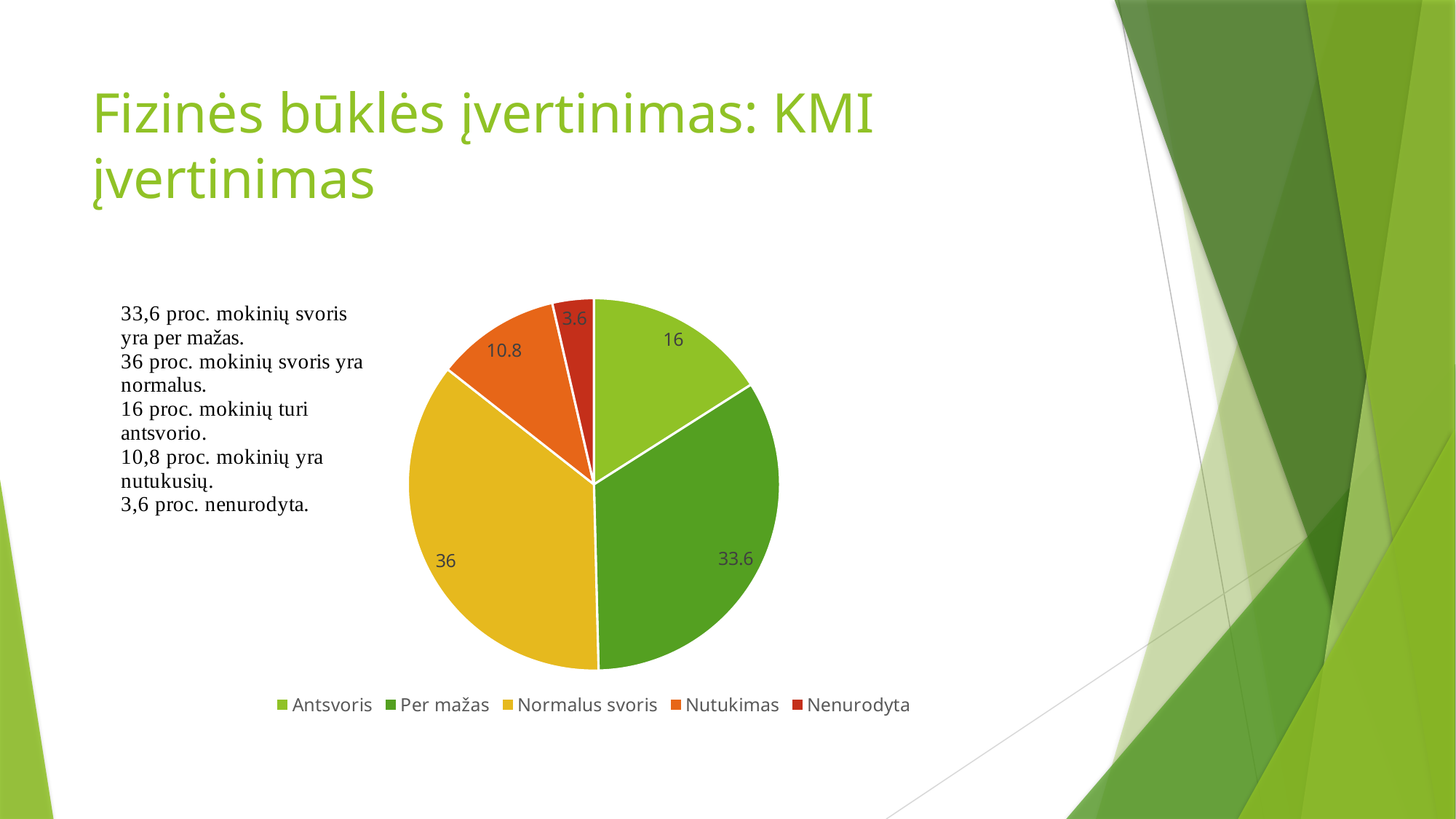
How many categories does the pie chart have? 5 What is the value for Antsvoris in the pie chart? 16 Which category has the smallest slice in the pie chart? Nenurodyta What is the value for Normalus svoris in the pie chart? 36 What colour is the Nutukimas slice in the pie chart? orange What is the value for Nutukimas in the pie chart? 10.8 Which category has the largest slice in the pie chart? Normalus svoris What is the value for Nenurodyta in the pie chart? 3.6 What is the value for Per mažas in the pie chart? 33.6 What is the difference between the values for Normalus svoris and Per mažas? 2.4 What kind of chart is shown on the slide? pie chart Which is larger, the value for Antsvoris or the value for Nutukimas? Antsvoris